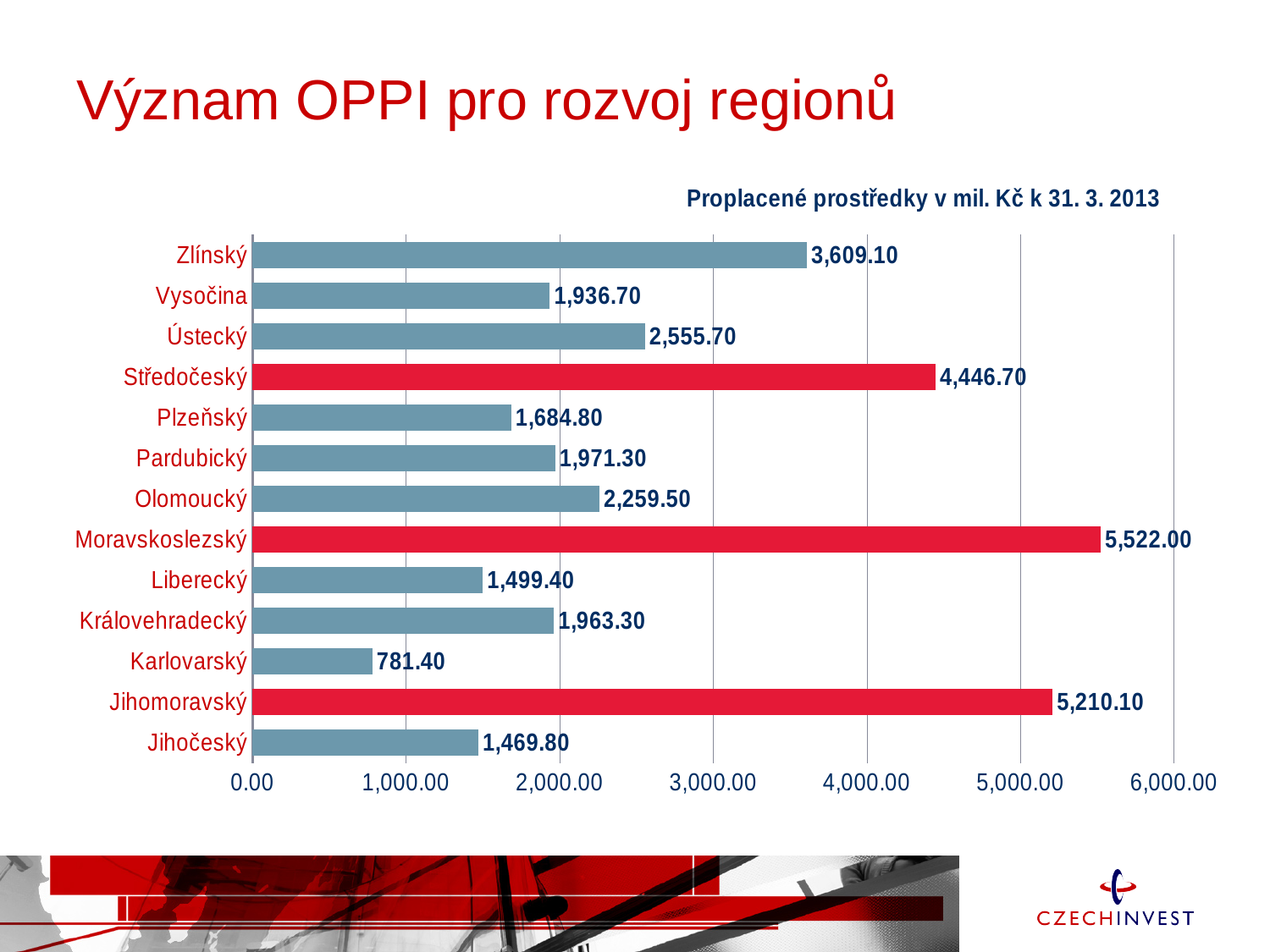
What is the value for Středočeský? 4,446.70 What is the value for Karlovarský? 781.40 What is the difference between the values for Středočeský and Zlínský? 837.60 What is the difference between the values for Moravskoslezský and Jihomoravský? 311.90 Which is larger, the value for Ústecký or the value for Olomoucký? Ústecký What is the value for Zlínský? 3,609.10 What is the title of the chart? Proplacené prostředky v mil. Kč k 31. 3. 2013 What kind of chart is shown on the slide? bar chart Is the value for Zlínský greater or less than 3,000.00? greater Which region has the highest value? Moravskoslezský How many regions are shown in the chart? 13 Which region has the lowest value? Karlovarský